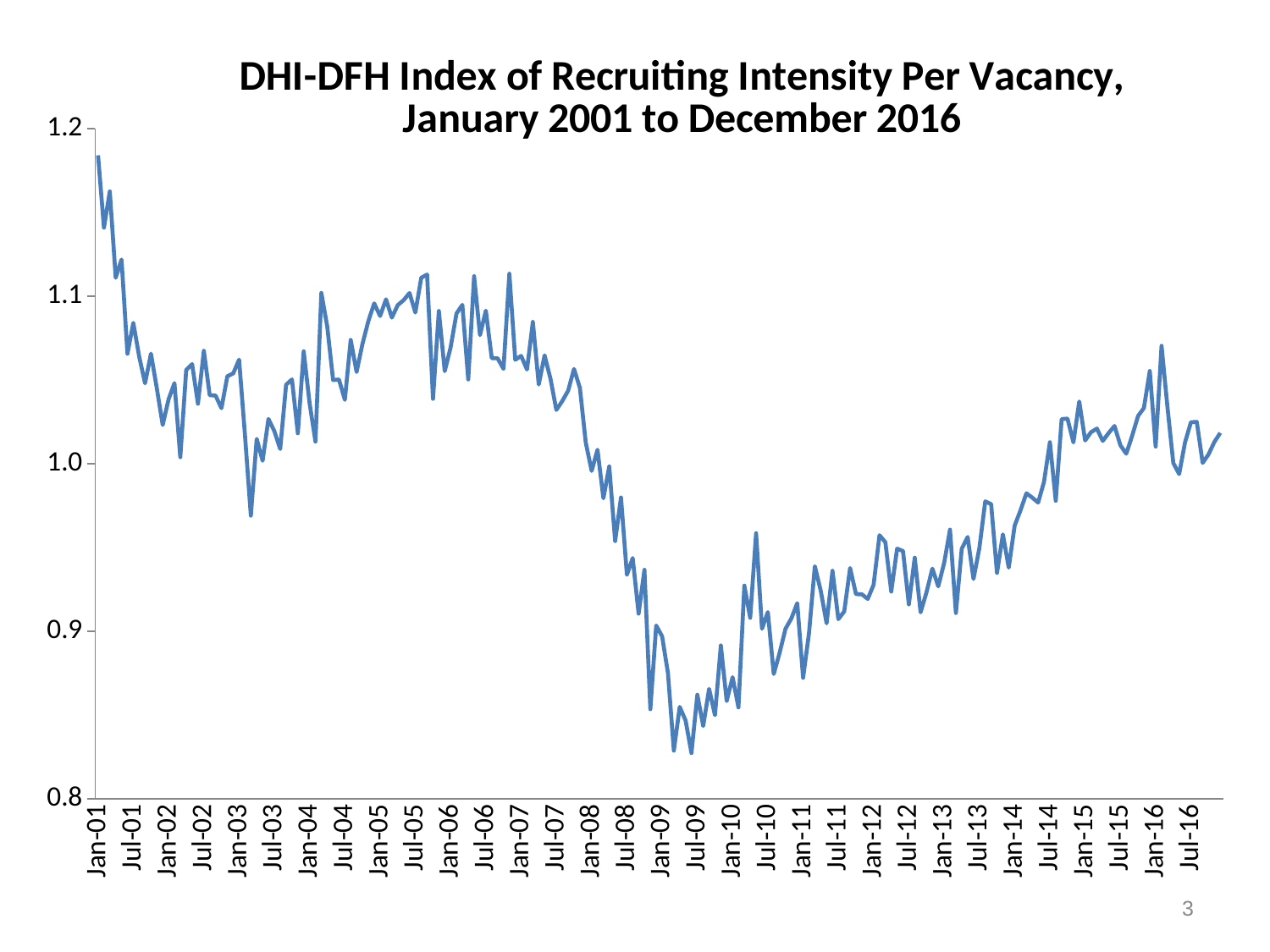
What is the title of the chart? DHI-DFH Index of Recruiting Intensity Per Vacancy, January 2001 to December 2016 Does the index rise or fall overall between Jan-01 and Jul-09? fall In which year does the line reach its lowest point? 2009 Is the value for Jul-09 greater or less than 0.9? less Does the index rise or fall overall between Jul-09 and Jan-16? rise What kind of chart is shown on the slide? line chart In which year does the line reach its highest point? 2001 Is the value for Jan-11 greater or less than 1.0? less Is the value for Jan-05 greater or less than 1.0? greater What is the lowest value shown on the vertical axis? 0.8